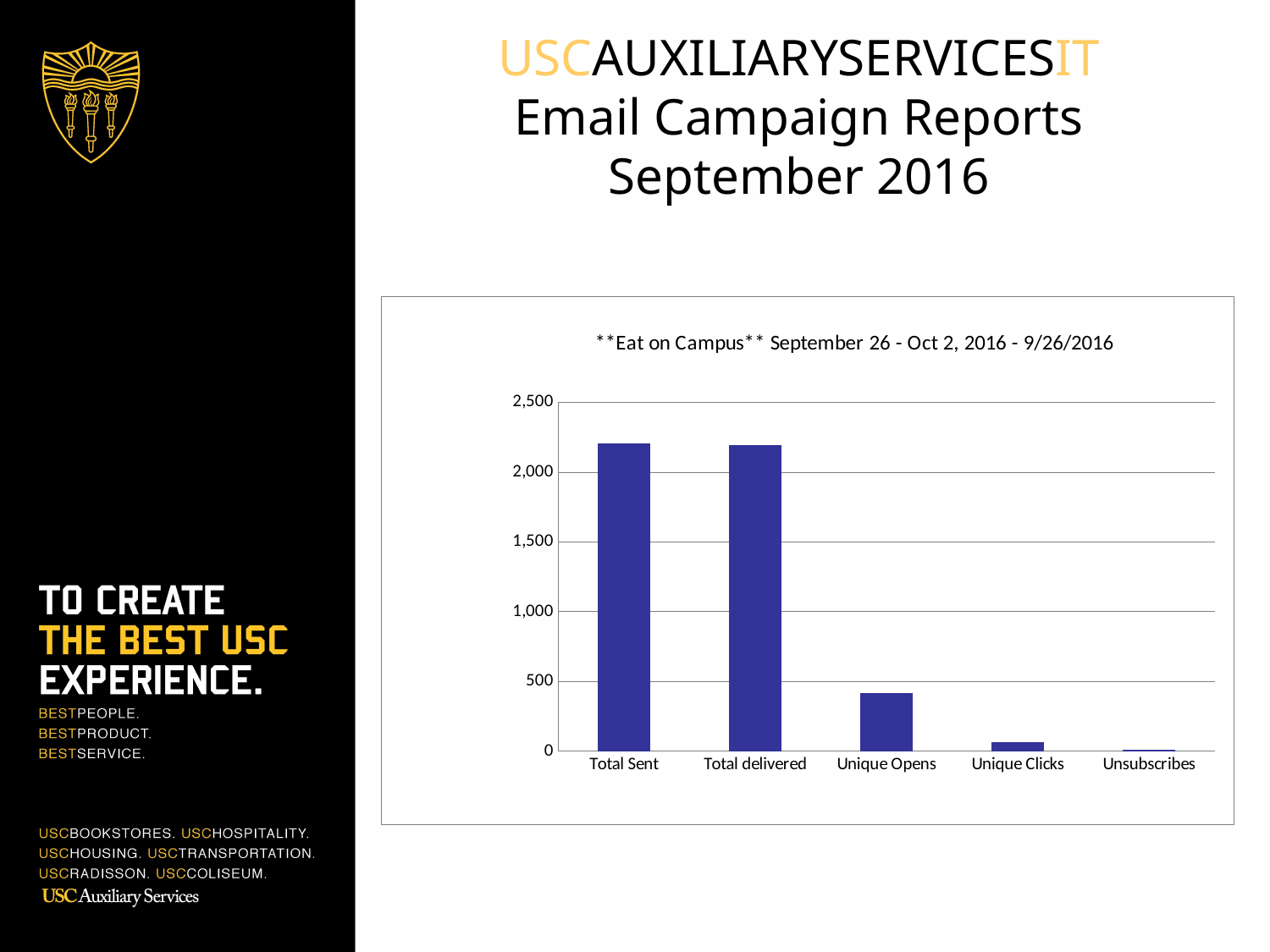
How many categories are shown on the x axis of the chart? 5 Is the value for Total delivered greater or less than 2,000? greater Is the value for Total Sent greater or less than 2,000? greater Which is larger, the value for Unique Opens or the value for Unique Clicks? Unique Opens Which category has the lowest value in the chart? Unsubscribes What is the title of the chart? **Eat on Campus** September 26 - Oct 2, 2016 - 9/26/2016 Do the values rise or fall moving from left to right along the x axis? fall Is the value for Unique Clicks greater or less than 500? less What kind of chart is shown on the slide? bar chart Which is larger, the value for Total Sent or the value for Unique Opens? Total Sent What is the highest value shown on the chart's vertical axis? 2,500